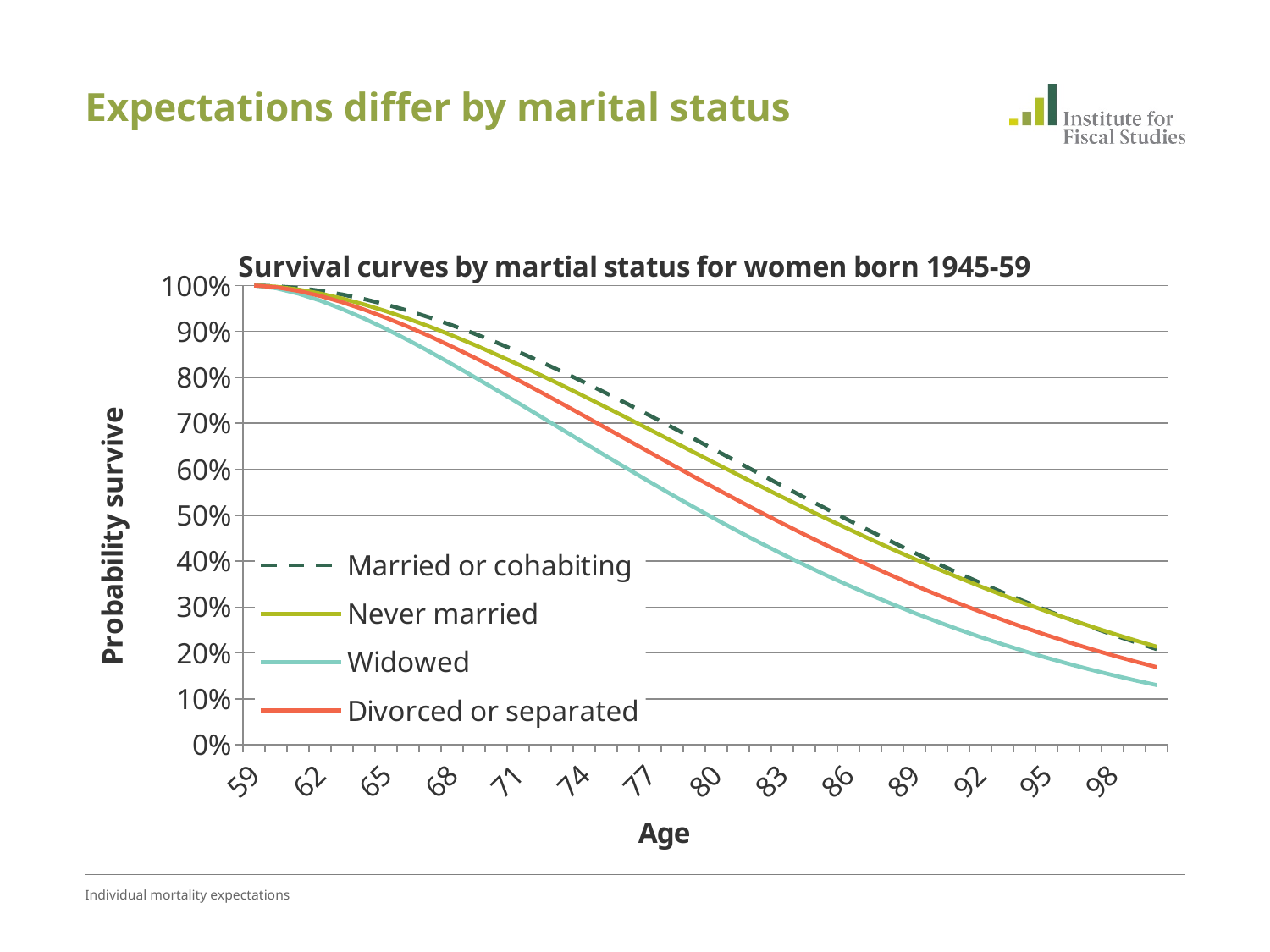
At age 80, which is higher: Married or cohabiting or Widowed? Married or cohabiting Which group has the highest probability of survival at age 80? Married or cohabiting How many series does the legend list? 4 Is the value for Widowed at age 71 greater or less than 70%? greater What kind of chart is shown on the slide? line chart What is the title of the chart? Survival curves by martial status for women born 1945-59 Which group has the lowest probability of survival at age 89? Widowed Is the value for Widowed at age 98 greater or less than 20%? less Which series is drawn with a dashed line? Married or cohabiting Is the value for Widowed at age 86 greater or less than 40%? less What is the probability of survival for all four groups at age 59? 100% Do the survival probabilities rise or fall as age increases? fall